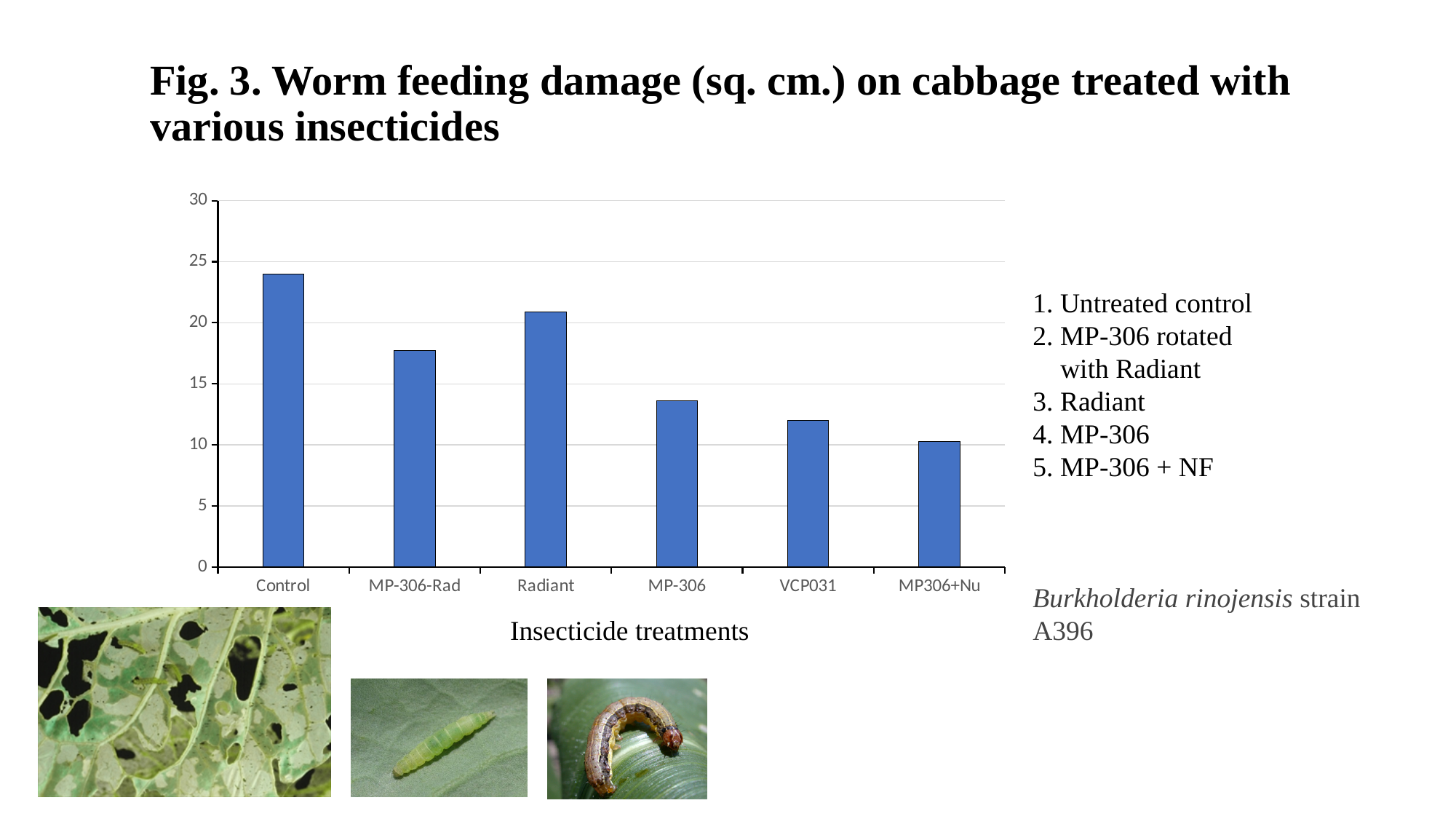
Is the value for Radiant greater or less than 25? less What is the label of the x axis? Insecticide treatments Is the value for MP-306 greater or less than 15? less How many insecticide treatments are plotted on the chart? 6 Which has the larger value, MP-306-Rad or MP-306? MP-306-Rad Is the value for Control greater or less than 20? greater Which treatment has the lowest worm feeding damage? MP306+Nu Which treatment has the highest worm feeding damage? Control What kind of chart is shown on the slide? bar chart Which has the larger value, Control or Radiant? Control